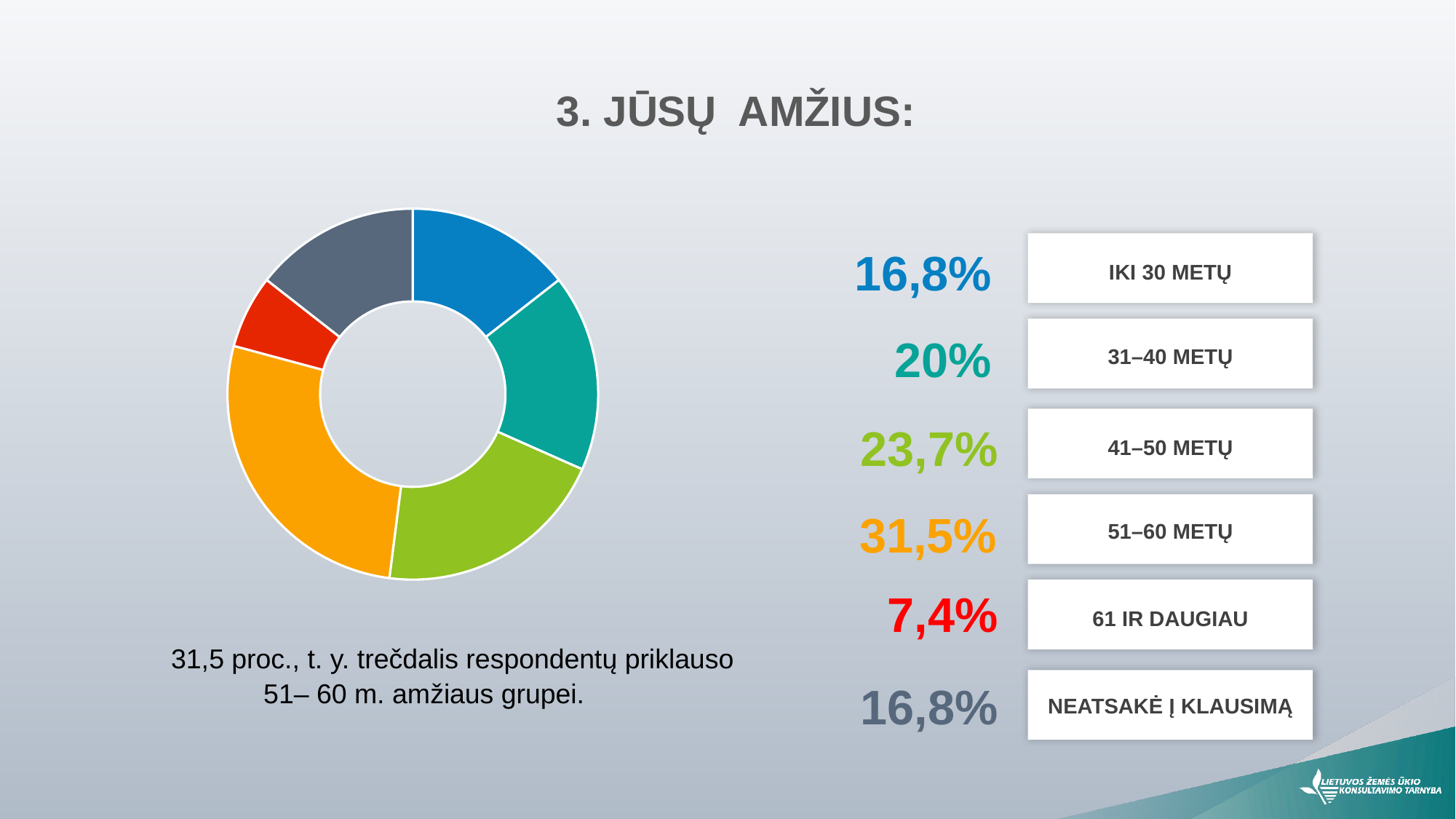
What value is shown for the 41–50 METŲ category? 23,7% Which age category has the largest share of respondents? 51–60 METŲ Which category has the smallest share? 61 IR DAUGIAU What percentage of respondents are in the 51–60 METŲ age group? 31,5% How many categories does the chart show? 6 What value is shown for NEATSAKĖ Į KLAUSIMĄ? 16,8% What colour represents the 51–60 METŲ category in the chart? Orange What is the difference in percentage points between 31–40 METŲ and IKI 30 METŲ? 3,2 What kind of chart is shown on the slide? Pie (donut) chart What percentage is shown for 61 IR DAUGIAU? 7,4% Which is larger: the share for 41–50 METŲ or for 31–40 METŲ? 41–50 METŲ What is the difference in percentage points between the 51–60 METŲ and 41–50 METŲ categories? 7,8